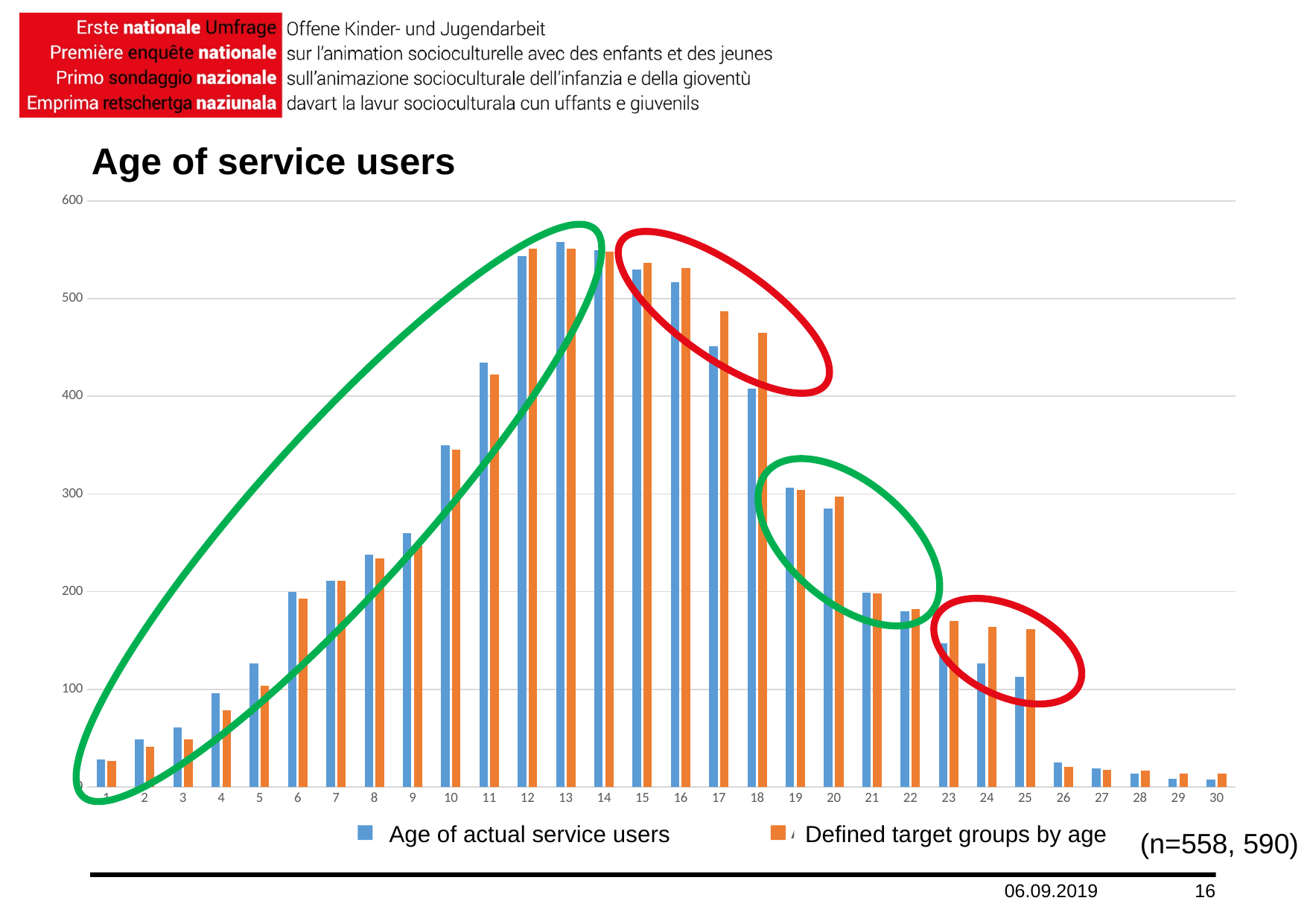
Is the value for 'Defined target groups by age' at age 4 greater or less than 100? less How many age categories are shown on the x axis? 30 What is the title of the chart? Age of service users How many series does the legend list? 2 Is the value for 'Age of actual service users' at age 12 greater or less than 500? greater At age 5, which series has the larger value: 'Age of actual service users' or 'Defined target groups by age'? Age of actual service users Is the value for 'Age of actual service users' at age 11 greater or less than 400? greater Which colour represents the series 'Defined target groups by age'? orange Do the values for 'Age of actual service users' rise or fall from age 15 to age 30? fall What kind of chart is shown on the slide? bar chart At age 18, which series has the larger value: 'Age of actual service users' or 'Defined target groups by age'? Defined target groups by age